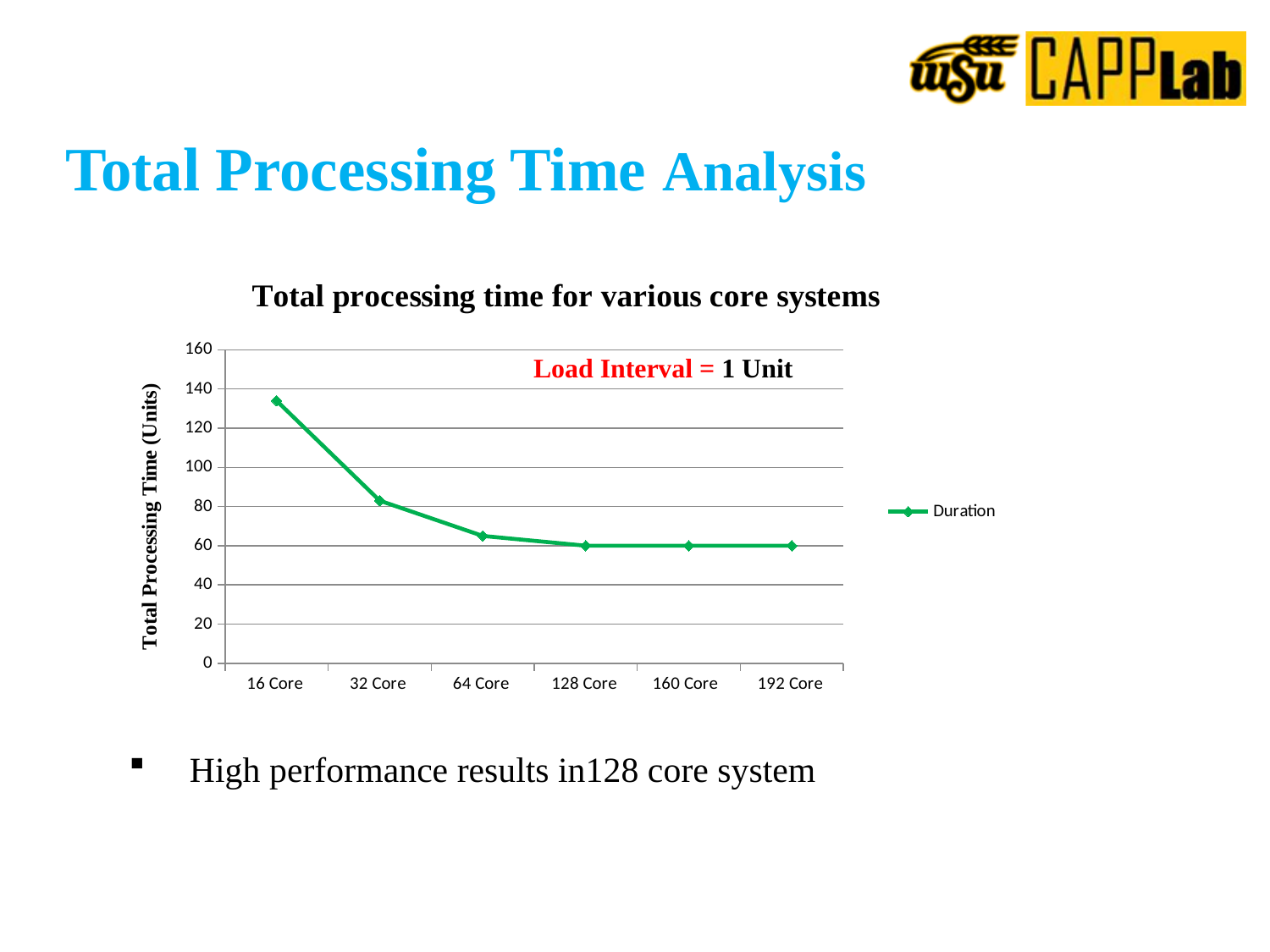
Which has a larger total processing time, 32 Core or 64 Core? 32 Core What type of chart is shown on the slide? Line chart Which has a larger total processing time, 16 Core or 32 Core? 16 Core What is the name of the series shown in the legend? Duration What is the title of the chart? Total processing time for various core systems Does the total processing time rise or fall as the number of cores increases from 16 Core to 128 Core? Fall How many core system categories are plotted on the x axis? 6 Is the total processing time for 16 Core greater or less than 120? greater Is the total processing time for 64 Core greater or less than 80? less Is the total processing time for 32 Core greater or less than 100? less How many series does the legend list? 1 Which core system has the highest total processing time? 16 Core